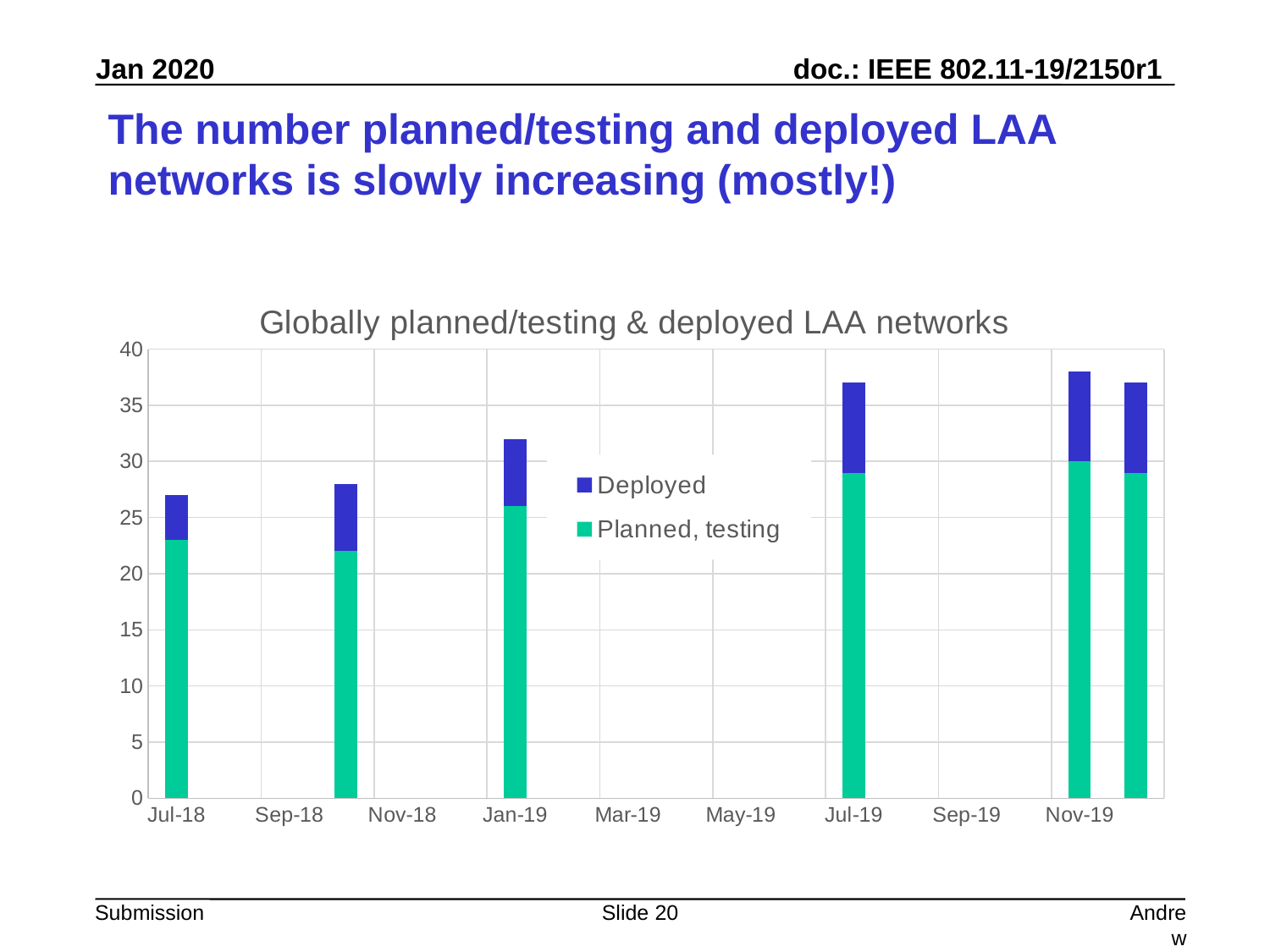
What kind of chart is shown on the slide? Stacked bar chart Is the total height of the Jul-19 bar greater or less than 35? greater Is the total height of the Jan-19 bar greater or less than 30? greater Is the total height of the Jul-18 bar greater or less than 25? greater How many series does the chart legend list? 2 Which series is shown in green in the chart? Planned, testing Do the total bar heights generally rise or fall from Jul-18 to Nov-19? Rise How many bars are plotted in the chart? 6 Which bar has the larger total, Jan-19 or Jul-19? Jul-19 What is the title of the chart? Globally planned/testing & deployed LAA networks